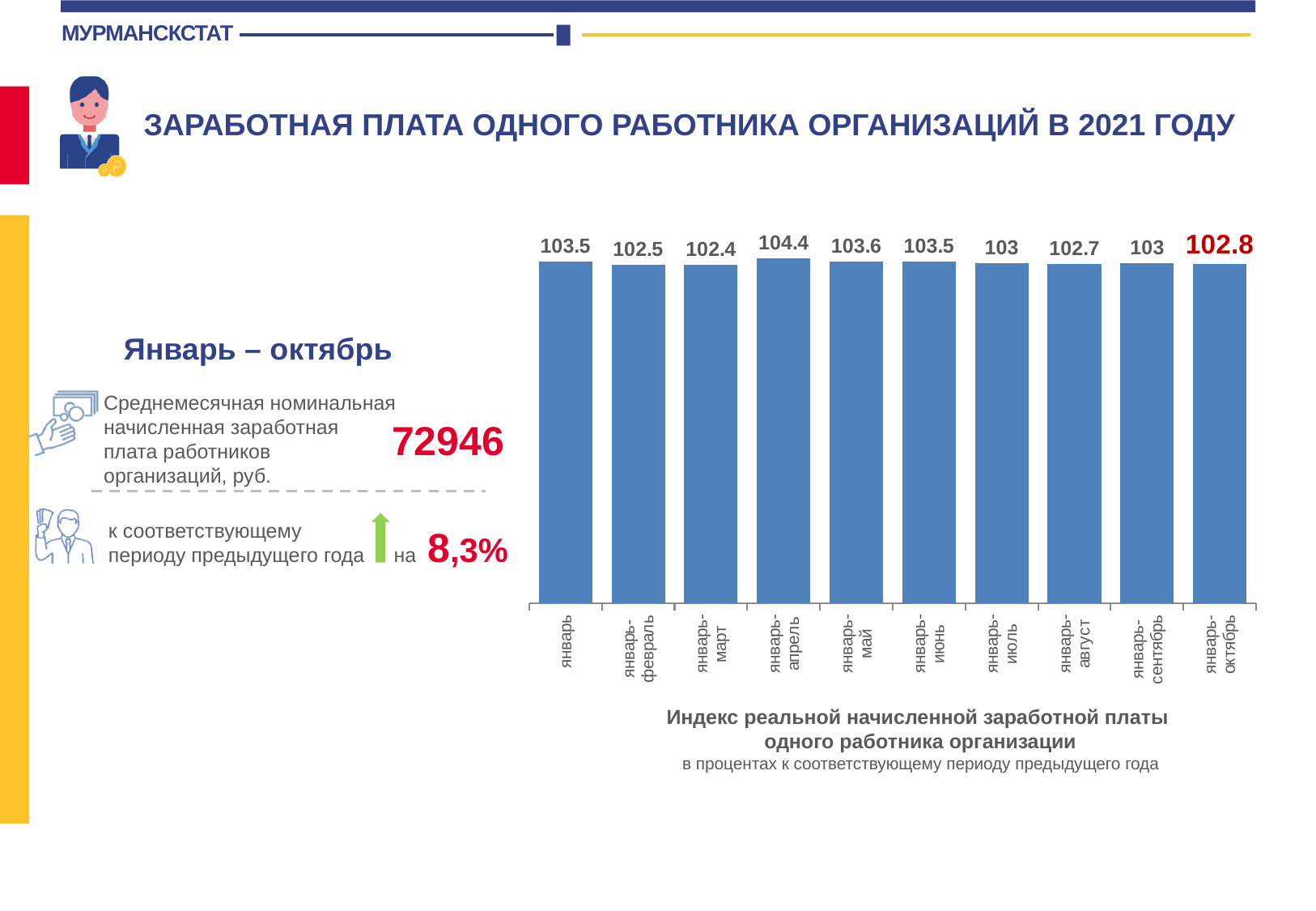
Do the values rise or fall from январь-апрель to январь-июль? fall What kind of chart is shown on the slide? bar chart Which period has the highest value? январь-апрель How many bars are shown in the chart? 10 Which period has the lowest value? январь-март What is the value for январь? 103.5 What is the difference between the values for январь-апрель and январь-март? 2 What is the value for январь-октябрь? 102.8 What is the value for январь-август? 102.7 What is the title of the chart? Индекс реальной начисленной заработной платы одного работника организации What is the value for январь-апрель? 104.4 Which is larger, the value for январь or the value for январь-октябрь? январь